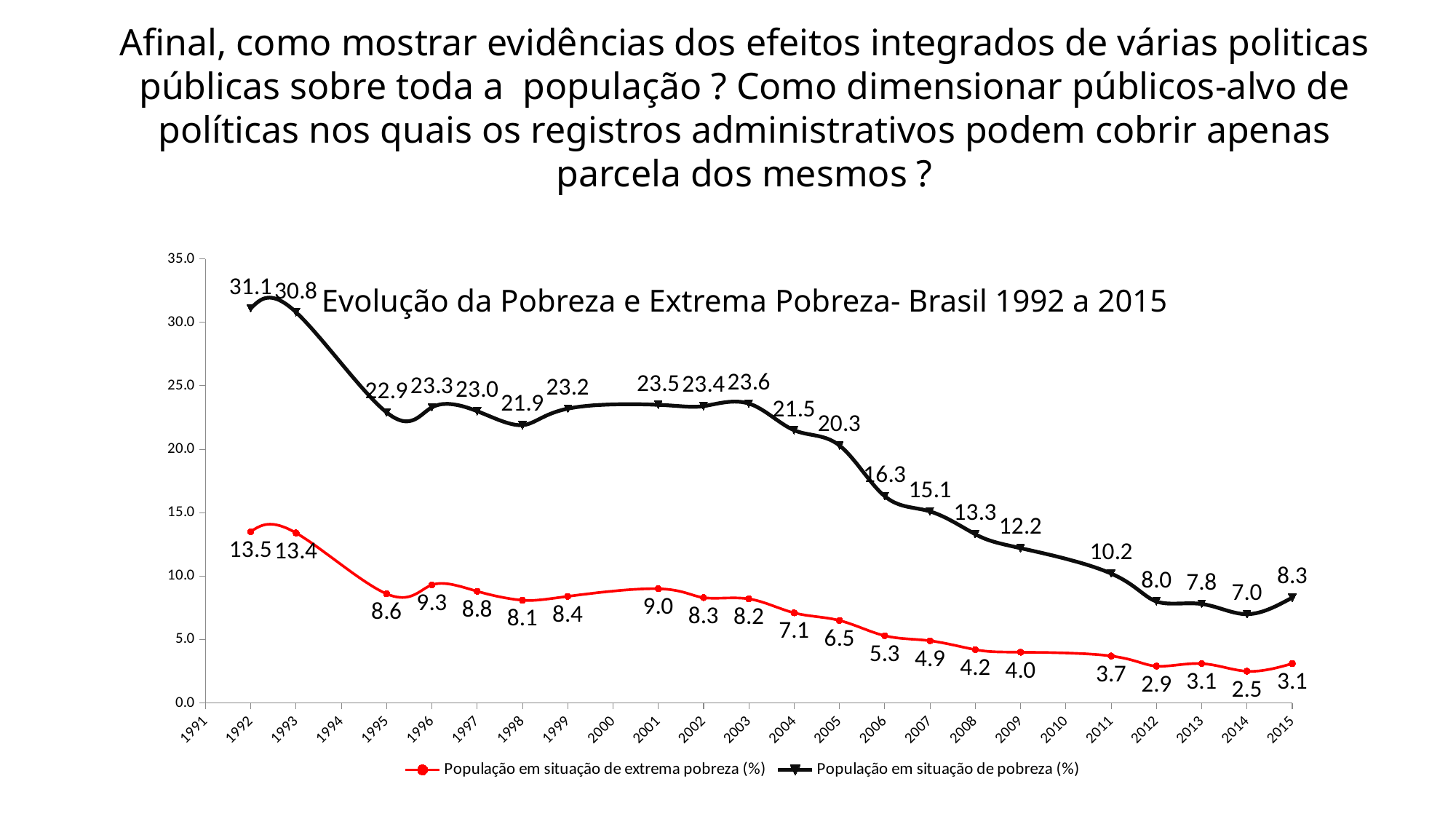
In which year is População em situação de extrema pobreza (%) lowest? 2014 What colour is the line for População em situação de extrema pobreza (%)? Red What is the overall trend of População em situação de pobreza (%) from 1992 to 2015? Falling What is the value for População em situação de pobreza (%) in 2014? 7.0 How many series does the legend list? 2 What is the value for População em situação de extrema pobreza (%) in 2005? 6.5 Which is larger for População em situação de pobreza (%): the value in 2006 or the value in 2009? 2006 What is the title of the chart? Evolução da Pobreza e Extrema Pobreza- Brasil 1992 a 2015 In which year is População em situação de pobreza (%) highest? 1992 What type of chart is shown on the slide? Line chart What is the value for População em situação de pobreza (%) in 1992? 31.1 What is the difference between População em situação de pobreza (%) and População em situação de extrema pobreza (%) in 2015? 5.2